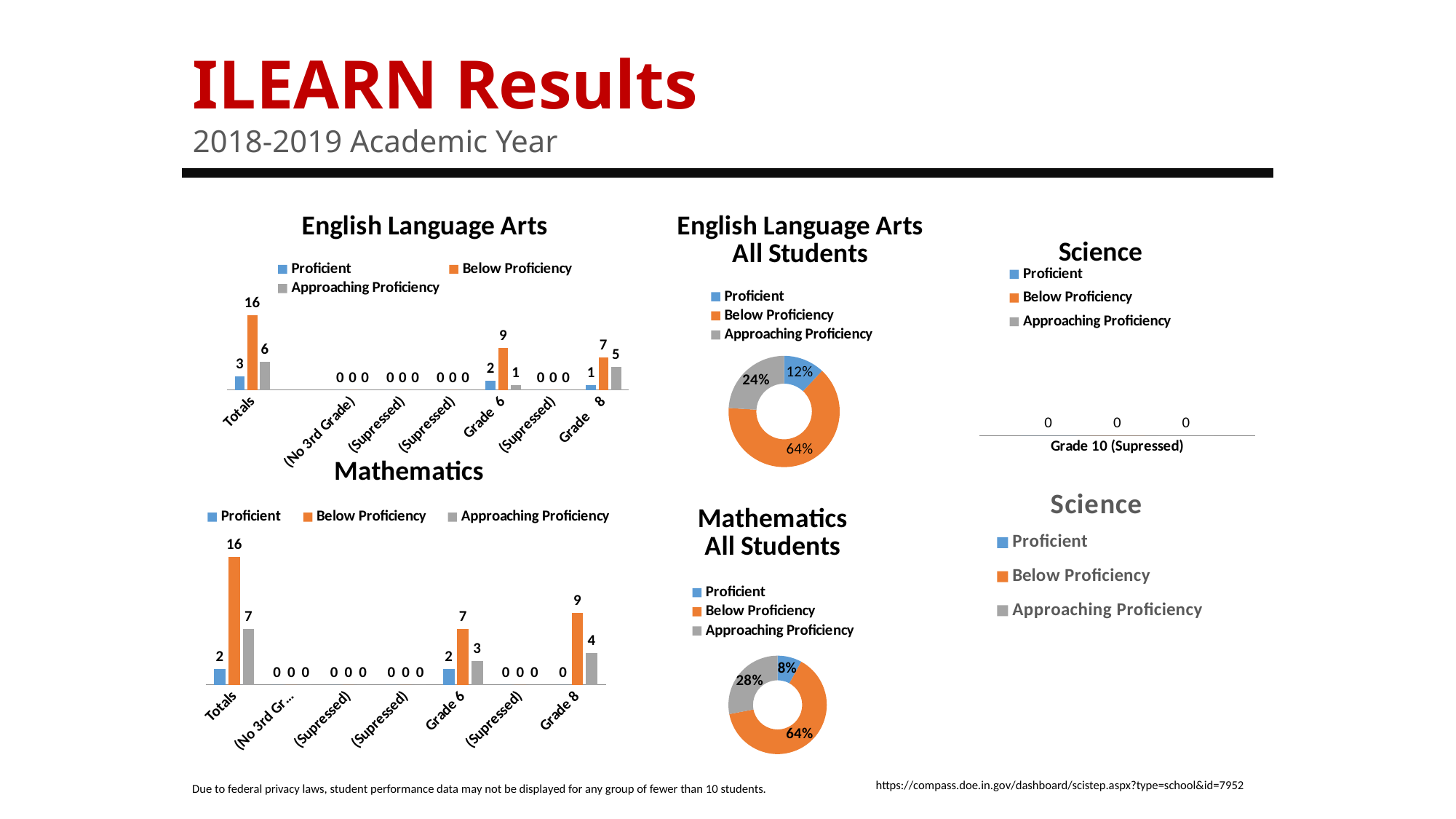
In the Mathematics bar chart, which category has the highest Below Proficiency value? Totals In the English Language Arts bar chart, what is the Approaching Proficiency value for Grade 8? 5 In the Mathematics All Students donut chart, what share is Proficient? 8% In the English Language Arts bar chart, which is larger for Grade 6: Below Proficiency or Approaching Proficiency? Below Proficiency How many series does the legend of the Mathematics bar chart list? 3 In the Mathematics bar chart, what is the Below Proficiency value for Grade 8? 9 In the Mathematics All Students donut chart, what share is Approaching Proficiency? 28% In the English Language Arts All Students donut chart, what share is Below Proficiency? 64% In the Mathematics bar chart, what is the difference between the Below Proficiency and Approaching Proficiency values for Totals? 9 In the English Language Arts bar chart, what is the Below Proficiency value for Totals? 16 What kind of chart is the English Language Arts All Students chart? Donut chart In the Science chart at the top right, what is the value shown for Grade 10 (Supressed) for each series? 0